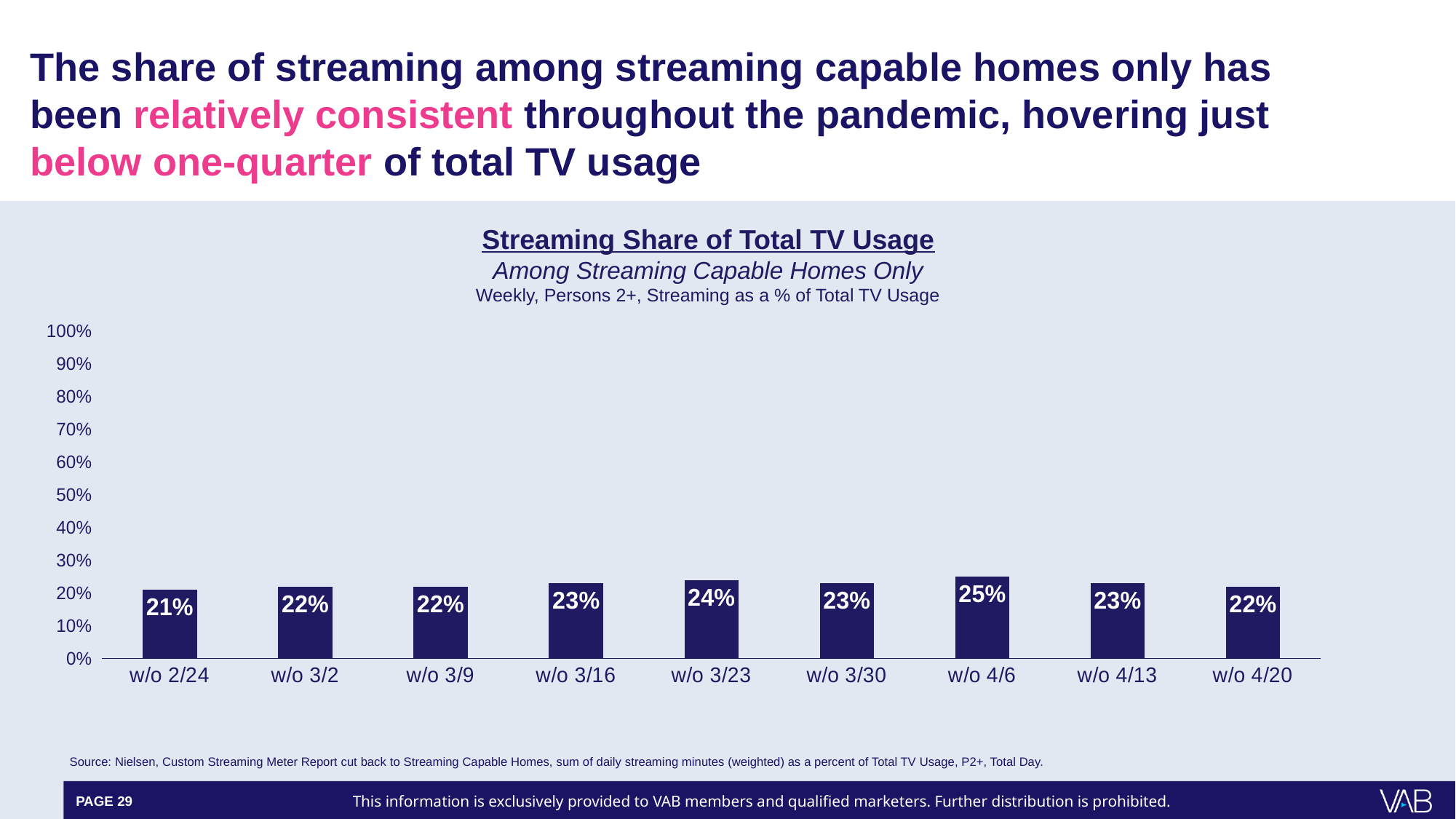
What is the streaming share of total TV usage for w/o 4/6? 25% What is the title of the chart? Streaming Share of Total TV Usage What is the difference between the streaming share for w/o 4/6 and w/o 2/24? 4% What kind of chart is shown on the slide? bar chart What is the streaming share of total TV usage for w/o 2/24? 21% Which week has the highest streaming share of total TV usage? w/o 4/6 Which week has the lowest streaming share of total TV usage? w/o 2/24 Which is larger, the streaming share for w/o 3/23 or w/o 3/30? w/o 3/23 Is the streaming share for w/o 3/16 greater or less than 50%? less What is the streaming share of total TV usage for w/o 4/20? 22% What is the streaming share of total TV usage for w/o 3/23? 24% How many weeks are shown on the chart? 9